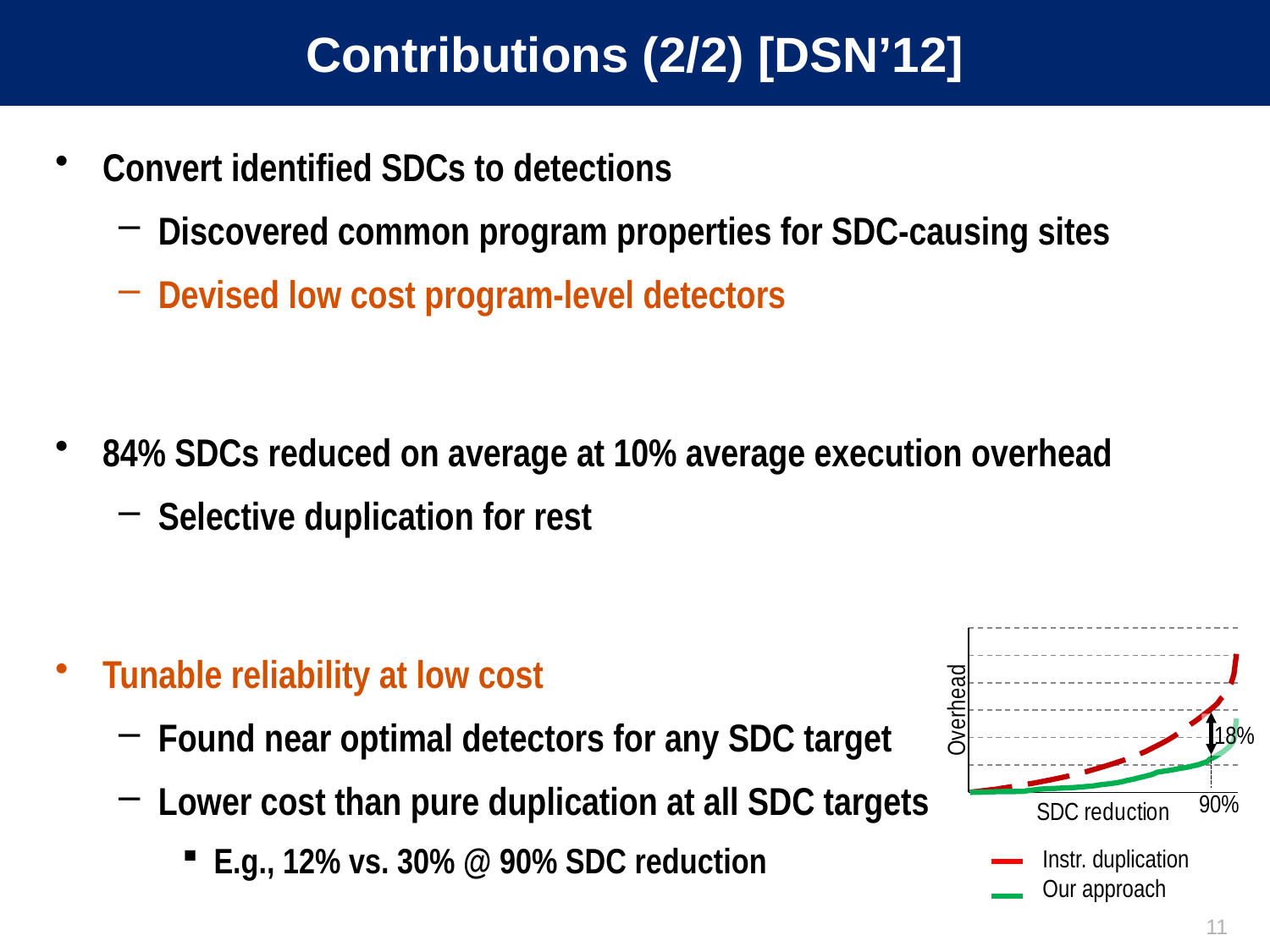
Which series has the higher overhead at 90% SDC reduction, Instr. duplication or Our approach? Instr. duplication What is the label on the x axis of the chart? SDC reduction How many series does the legend of the chart list? 2 What kind of chart is shown at the bottom right of the slide? line chart What gap in overhead between the two series is annotated on the chart at 90% SDC reduction? 18% Does the overhead for Instr. duplication rise or fall as SDC reduction increases along the x axis? rise Which series has the lower overhead across the SDC reduction range shown in the chart? Our approach What is the label on the y axis of the chart? Overhead Does the overhead for Our approach rise or fall as SDC reduction increases along the x axis? rise What are the two series named in the chart's legend? Instr. duplication and Our approach Which series is drawn as a dashed line in the chart? Instr. duplication What SDC reduction value is marked on the x axis of the chart? 90%